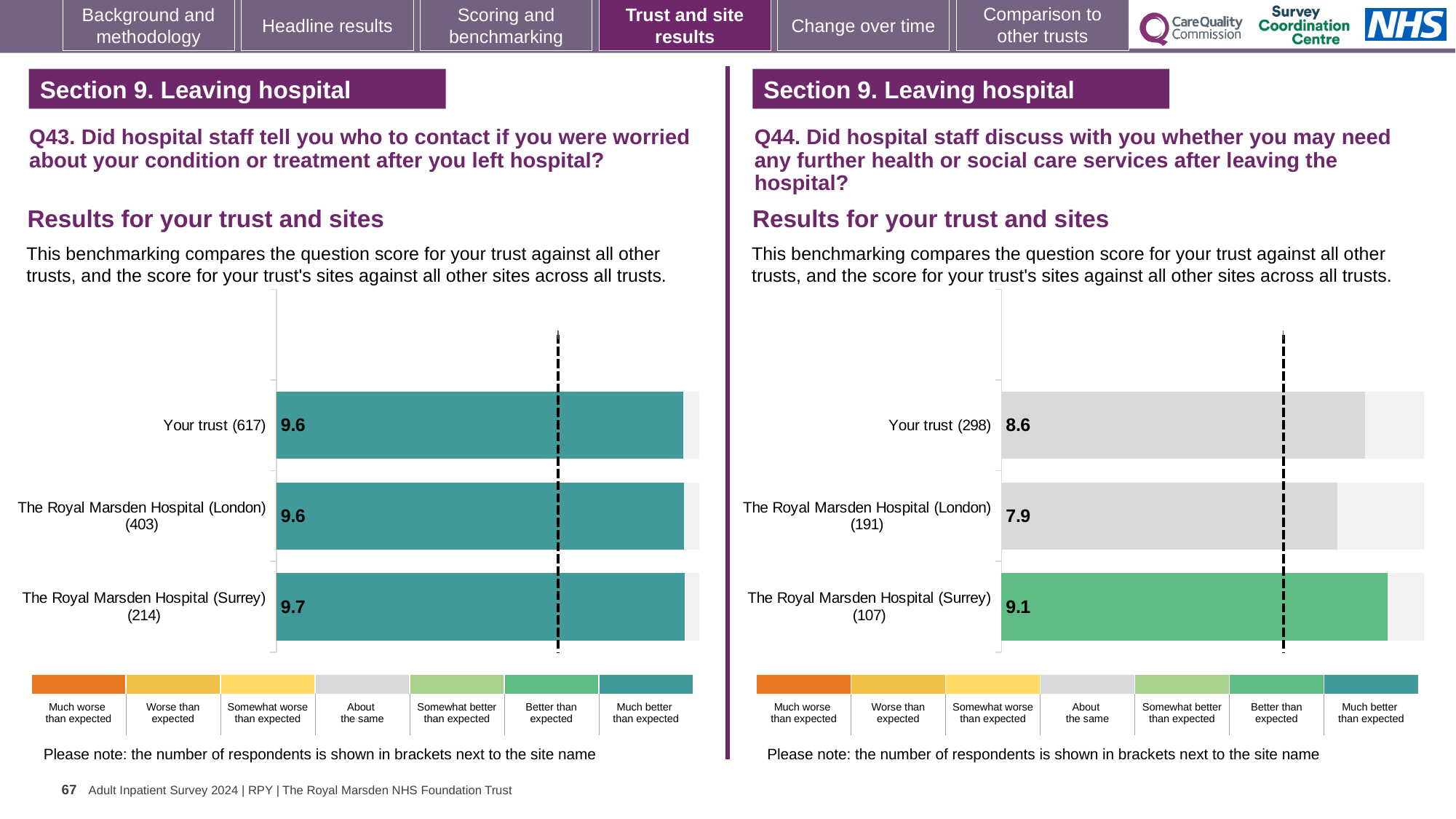
How many bars are shown on the Q43 chart (left)? 3 On the Q43 chart (left), what is the score for Your trust (617)? 9.6 On the Q43 chart (left), what is the difference between the scores for The Royal Marsden Hospital (Surrey) and Your trust? 0.1 On the Q44 chart (right), which site or trust has the highest score? The Royal Marsden Hospital (Surrey) On the Q44 chart (right), what is the score for The Royal Marsden Hospital (London) (191)? 7.9 What kind of chart is used on the Q44 chart (right)? Bar chart On the Q44 chart (right), what is the score for Your trust (298)? 8.6 On the Q43 chart (left), what is the score for The Royal Marsden Hospital (Surrey) (214)? 9.7 On the Q44 chart (right), which is larger: the score for Your trust or the score for The Royal Marsden Hospital (London)? Your trust On the Q44 chart (right), which site or trust has the lowest score? The Royal Marsden Hospital (London) On the Q44 chart (right), which benchmark category does the colour of the bar for The Royal Marsden Hospital (Surrey) correspond to? Better than expected On the Q44 chart (right), what is the difference between the scores for The Royal Marsden Hospital (Surrey) and The Royal Marsden Hospital (London)? 1.2